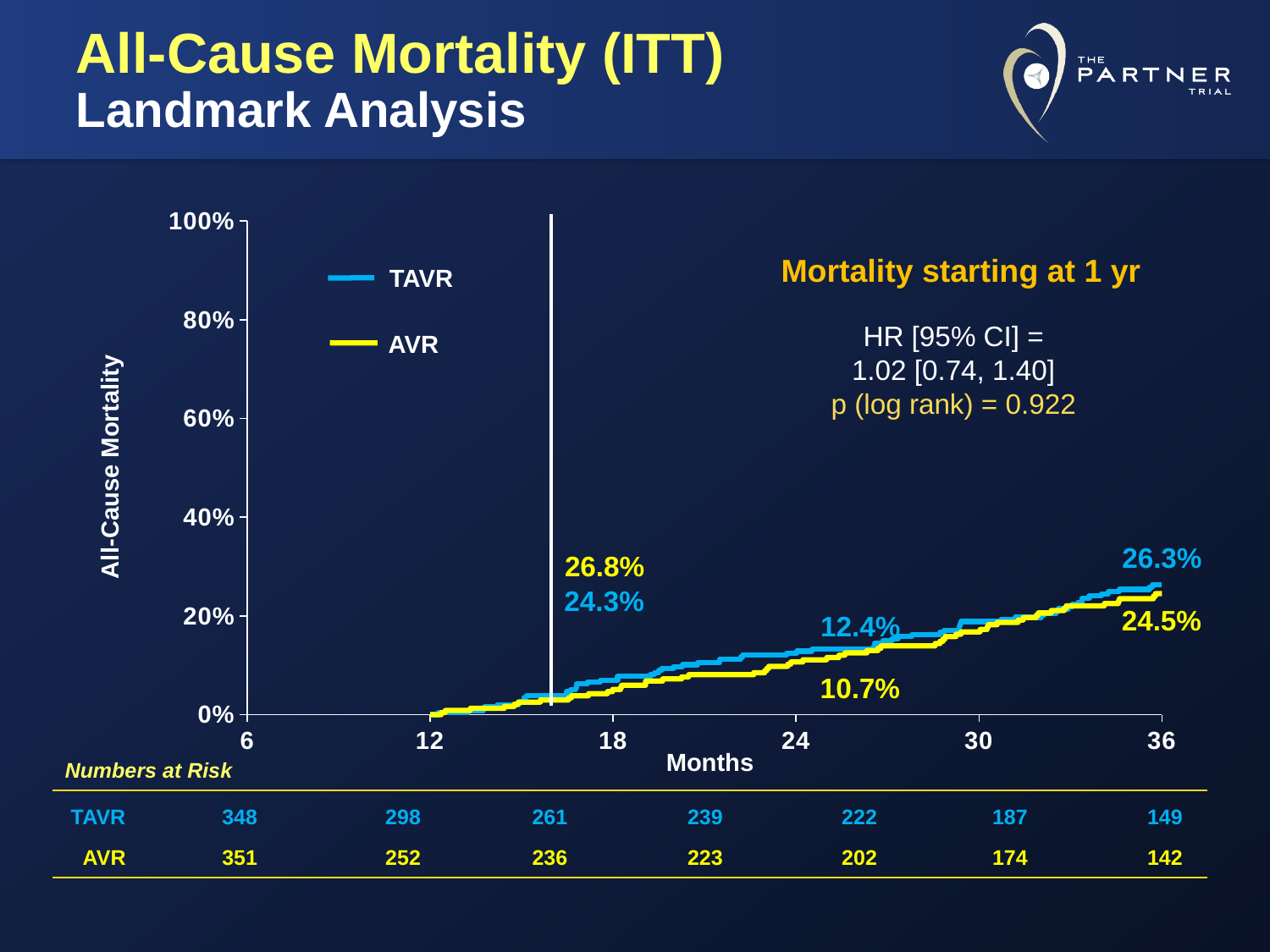
How many series does the legend list? 2 What is the AVR mortality value labelled near 24 months? 10.7% Is the TAVR mortality value at 36 months greater or less than 40%? less What is the all-cause mortality value labelled for TAVR at 36 months? 26.3% What log-rank p value is printed on the chart? 0.922 What is the TAVR mortality value labelled near 24 months? 12.4% What hazard ratio with 95% CI is printed on the chart for mortality starting at 1 year? 1.02 [0.74, 1.40] What is the all-cause mortality value labelled for AVR at 36 months? 24.5% Do the mortality curves rise or fall as months increase from 12 to 36? Rise What is the difference between the TAVR and AVR mortality values labelled at 36 months? 1.8 percentage points At 36 months, which group has the higher labelled all-cause mortality, TAVR or AVR? TAVR What kind of chart is shown on the slide? Line chart